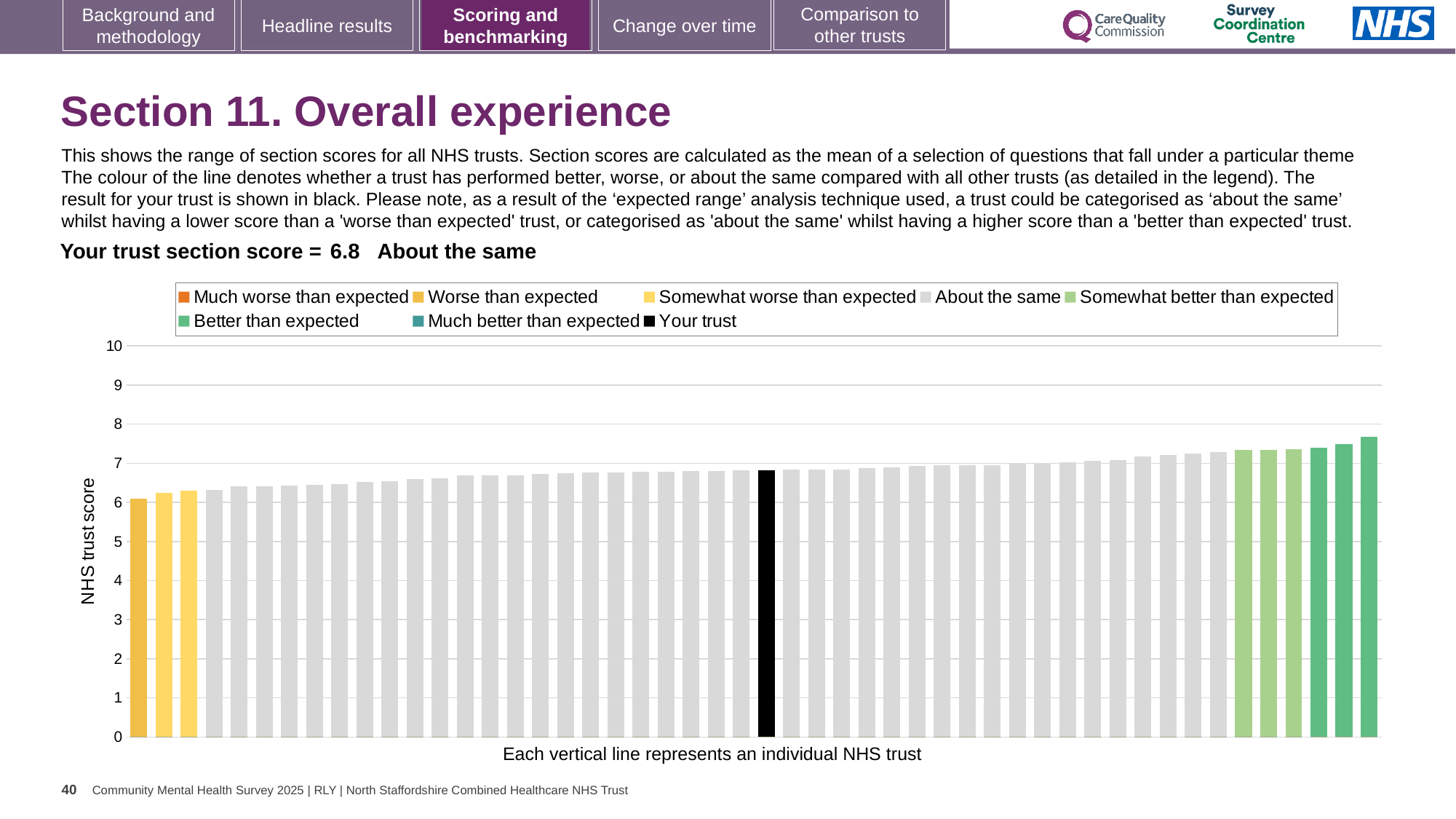
What colour is the bar representing your trust? black What is the title of the vertical axis? NHS trust score How many entries does the chart legend list? 8 Is the value of the black 'Your trust' bar greater or less than 5? greater Do the bar values rise or fall from left to right along the x axis? rise Is the value of the tallest bar greater or less than 8? less Which bar has the lowest value, the leftmost or the rightmost? leftmost Which category is your trust placed in for this section? About the same What kind of chart is shown on the slide? bar chart Which bar has the highest value, the leftmost or the rightmost? rightmost Is the value of the leftmost bar greater or less than 5? greater What is the section score for your trust shown on the slide? 6.8